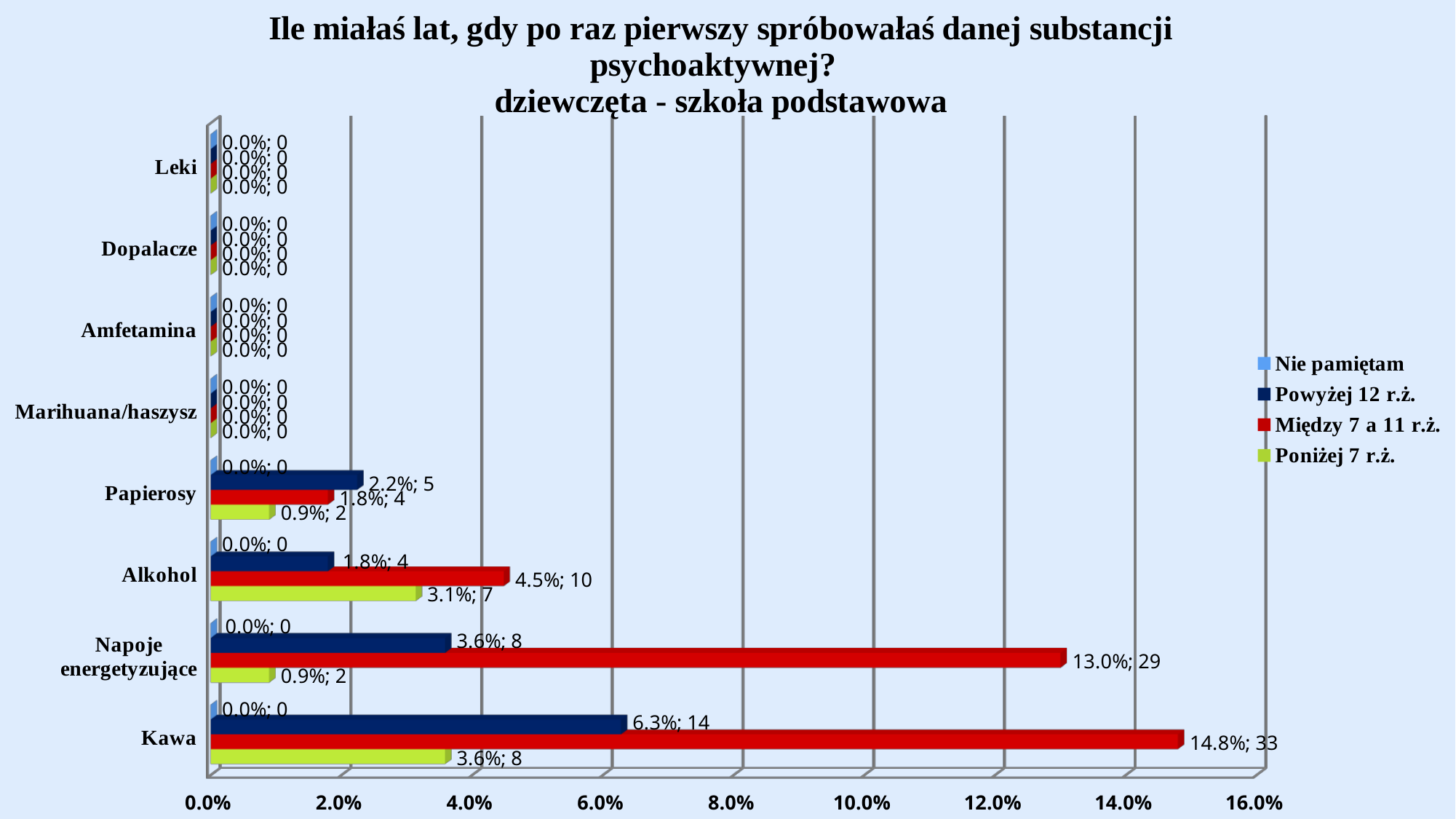
What is the maximum value shown on the x axis? 16.0% For Alkohol, which is larger: the 'Między 7 a 11 r.ż.' value or the 'Powyżej 12 r.ż.' value? Między 7 a 11 r.ż. What is the percentage value for Napoje energetyzujące in the 'Powyżej 12 r.ż.' series? 3.6% What kind of chart is shown on the slide? bar chart What is the difference between the 'Między 7 a 11 r.ż.' values for Kawa and Napoje energetyzujące? 1.8% How many series does the legend list? 4 What is the percentage value for Alkohol in the 'Poniżej 7 r.ż.' series? 3.1% How many substance categories are shown on the y axis? 8 Which category has the highest value in the 'Między 7 a 11 r.ż.' series? Kawa What is the percentage value for Kawa in the 'Między 7 a 11 r.ż.' series? 14.8% Which category has the highest value in the 'Powyżej 12 r.ż.' series? Kawa Is the 'Między 7 a 11 r.ż.' value for Napoje energetyzujące greater or less than 12.0%? greater